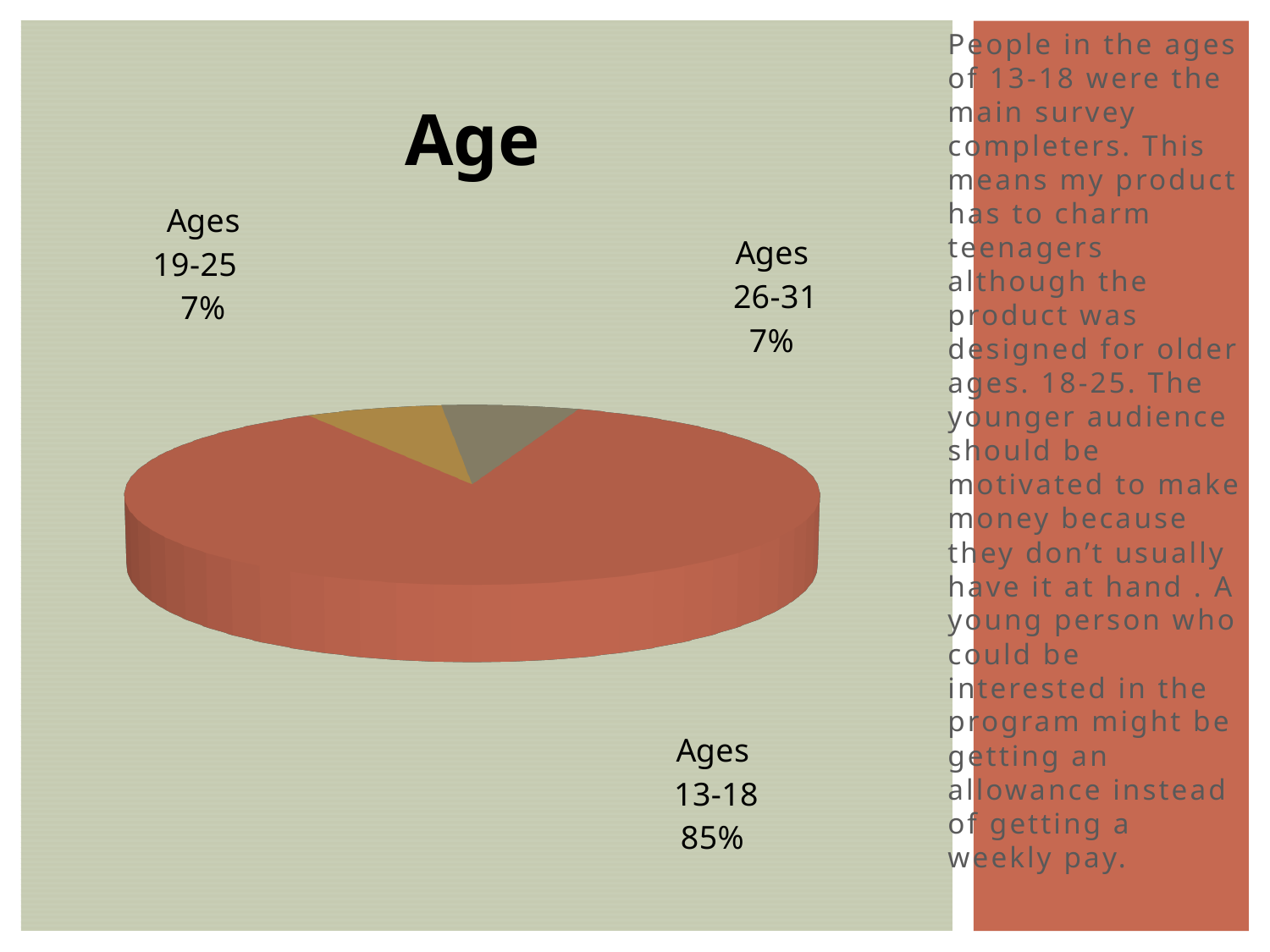
Is the share for Ages 13-18 greater or less than 50%? greater Which is larger, the share for Ages 13-18 or the share for Ages 26-31? Ages 13-18 Which age group has the largest share of the pie? Ages 13-18 What kind of chart is shown on the slide? Pie chart What share of the pie is Ages 26-31? 7% What is the title of the chart? Age How many slices does the pie chart have? 3 What share of the pie is Ages 19-25? 7% What colour is the Ages 13-18 slice? Red What is the difference in percentage points between Ages 13-18 and Ages 19-25? 78 What share of the pie is Ages 13-18? 85%